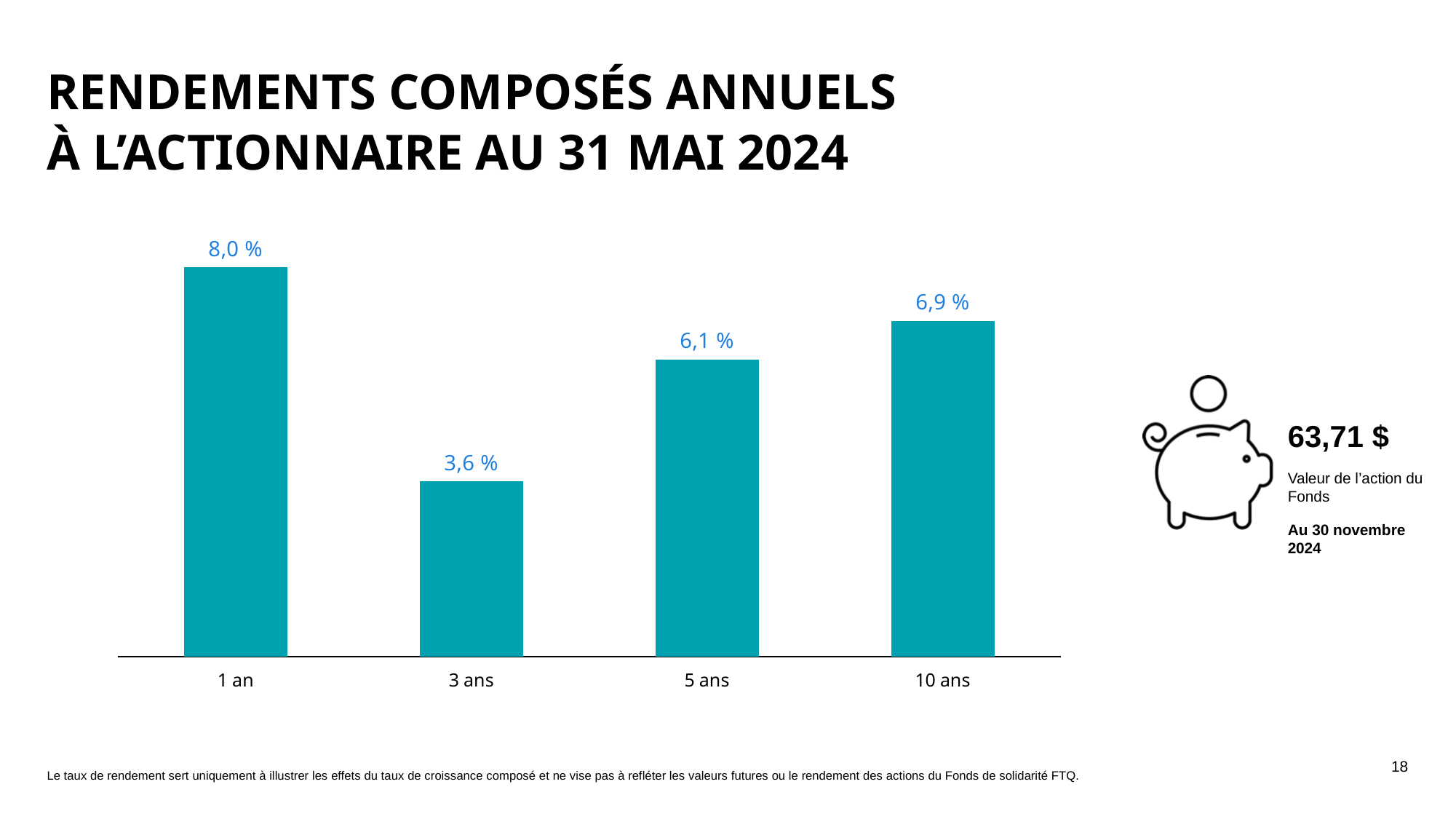
What is the annual compound return shown for 3 ans? 3,6 % How many periods are shown on the chart? 4 What is the annual compound return shown for 1 an? 8,0 % What is the difference between the return for 10 ans and the return for 5 ans? 0,8 % What kind of chart is shown on the slide? Bar chart Which is larger, the return for 5 ans or the return for 10 ans? 10 ans What is the annual compound return shown for 10 ans? 6,9 % What is the annual compound return shown for 5 ans? 6,1 % Which period has the lowest annual compound return? 3 ans What is the value of the Fund's share shown next to the piggy bank icon? 63,71 $ What is the difference between the return for 1 an and the return for 3 ans? 4,4 % Which period has the highest annual compound return? 1 an